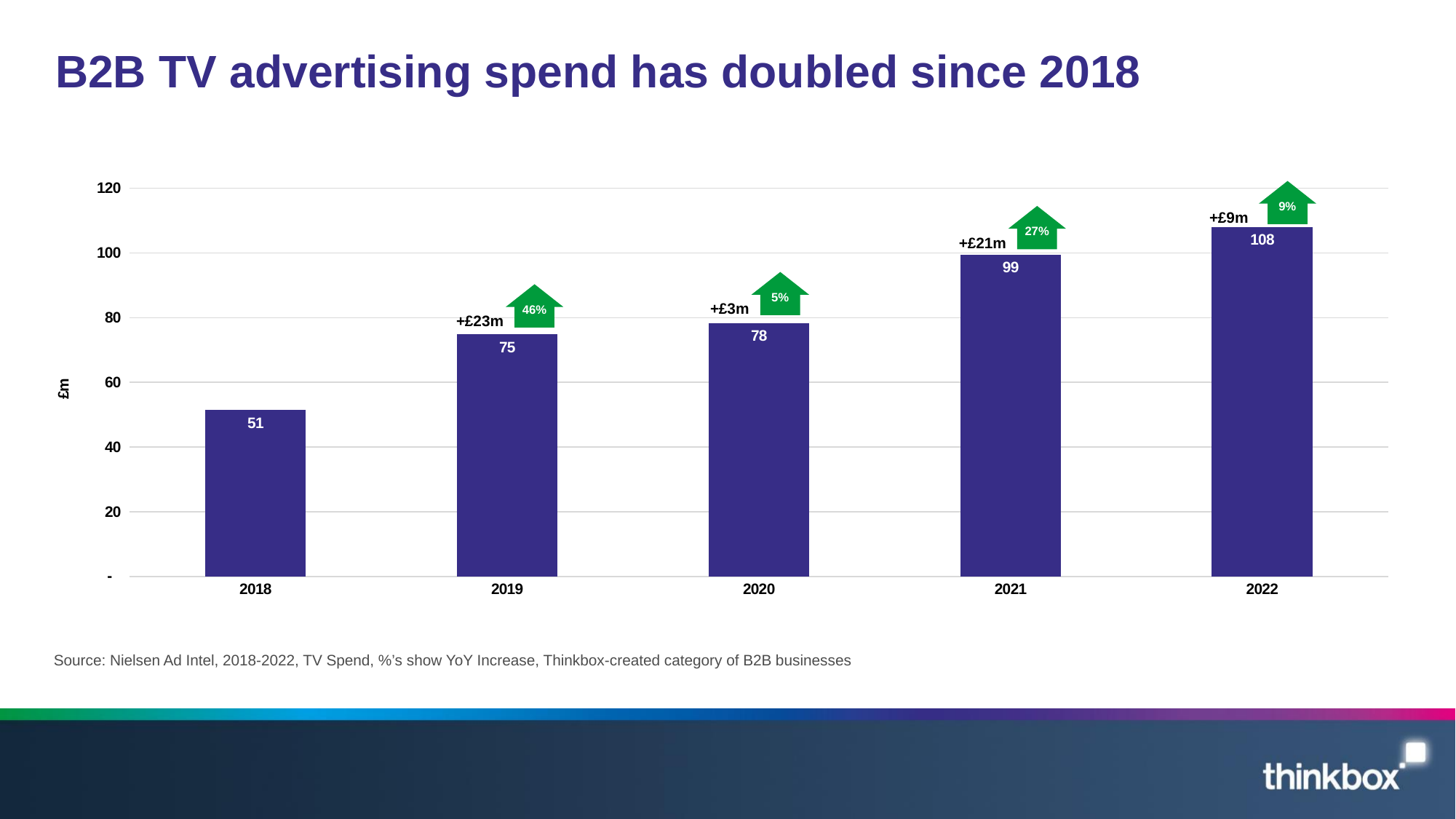
What is the B2B TV advertising spend (£m) for 2018? 51 What is the B2B TV advertising spend (£m) for 2020? 78 What kind of chart is shown on the slide? Bar chart Which year has the highest B2B TV advertising spend? 2022 What year-on-year percentage increase is shown for 2019? 46% Which year has the larger spend, 2019 or 2021? 2021 Is the value for 2021 greater or less than 80? greater What is the difference in spend (£m) between 2022 and 2018? 57 Which year has the lowest B2B TV advertising spend? 2018 What is the B2B TV advertising spend (£m) for 2022? 108 What is the difference in spend (£m) between 2021 and 2020? 21 How many years are shown on the chart? 5